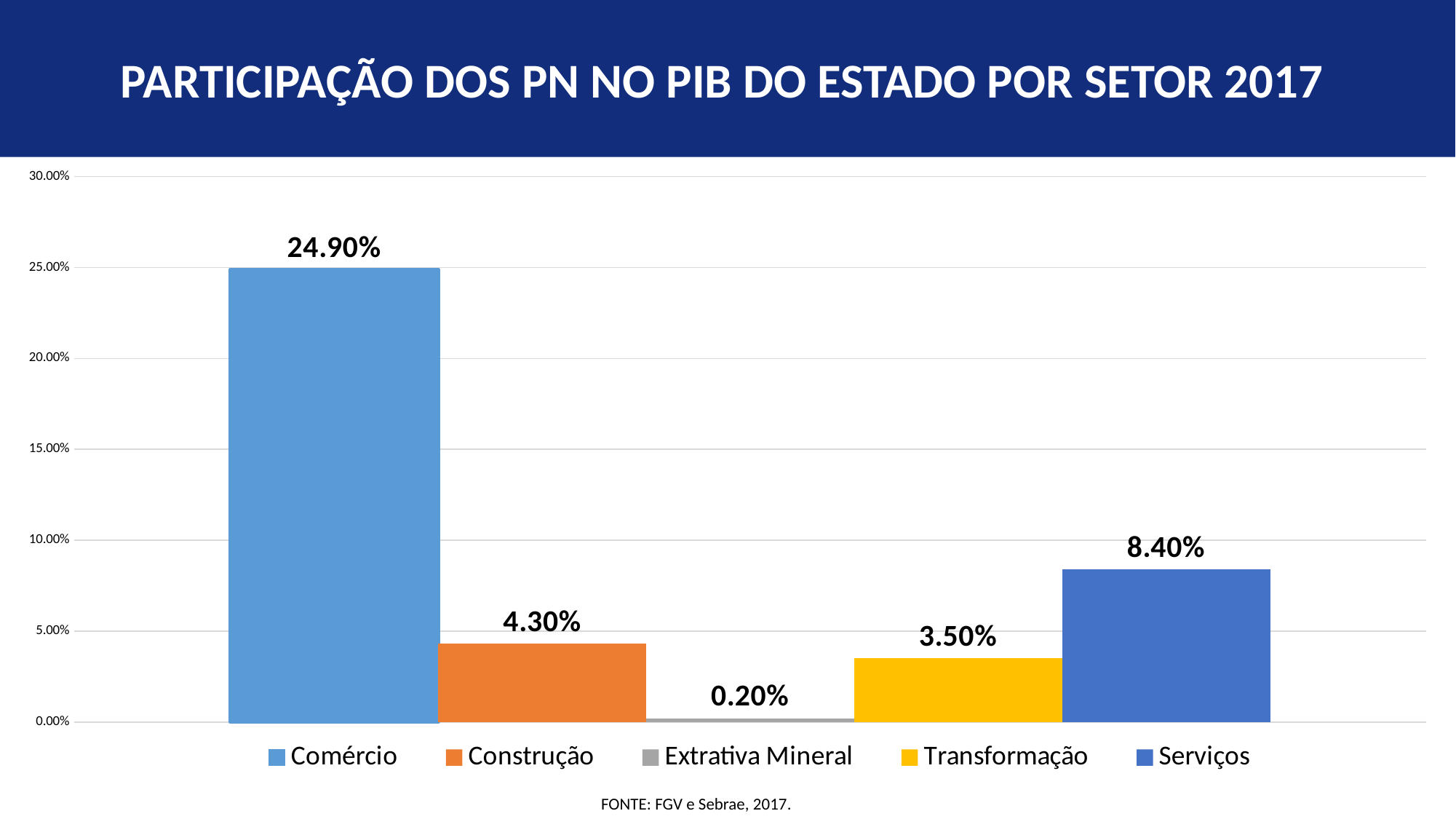
Which is larger, the value for Construção or the value for Transformação? Construção What is the difference between the values for Construção and Transformação? 0.80% What is the value for Comércio? 24.90% Which sector has the highest value? Comércio What kind of chart is shown on the slide? Bar chart Is the value for Serviços greater or less than 10.00%? less What is the value for Transformação? 3.50% How many sectors are shown in the chart? 5 What is the value for Extrativa Mineral? 0.20% What is the value for Serviços? 8.40% Which sector has the lowest value? Extrativa Mineral What is the difference between the values for Comércio and Serviços? 16.50%